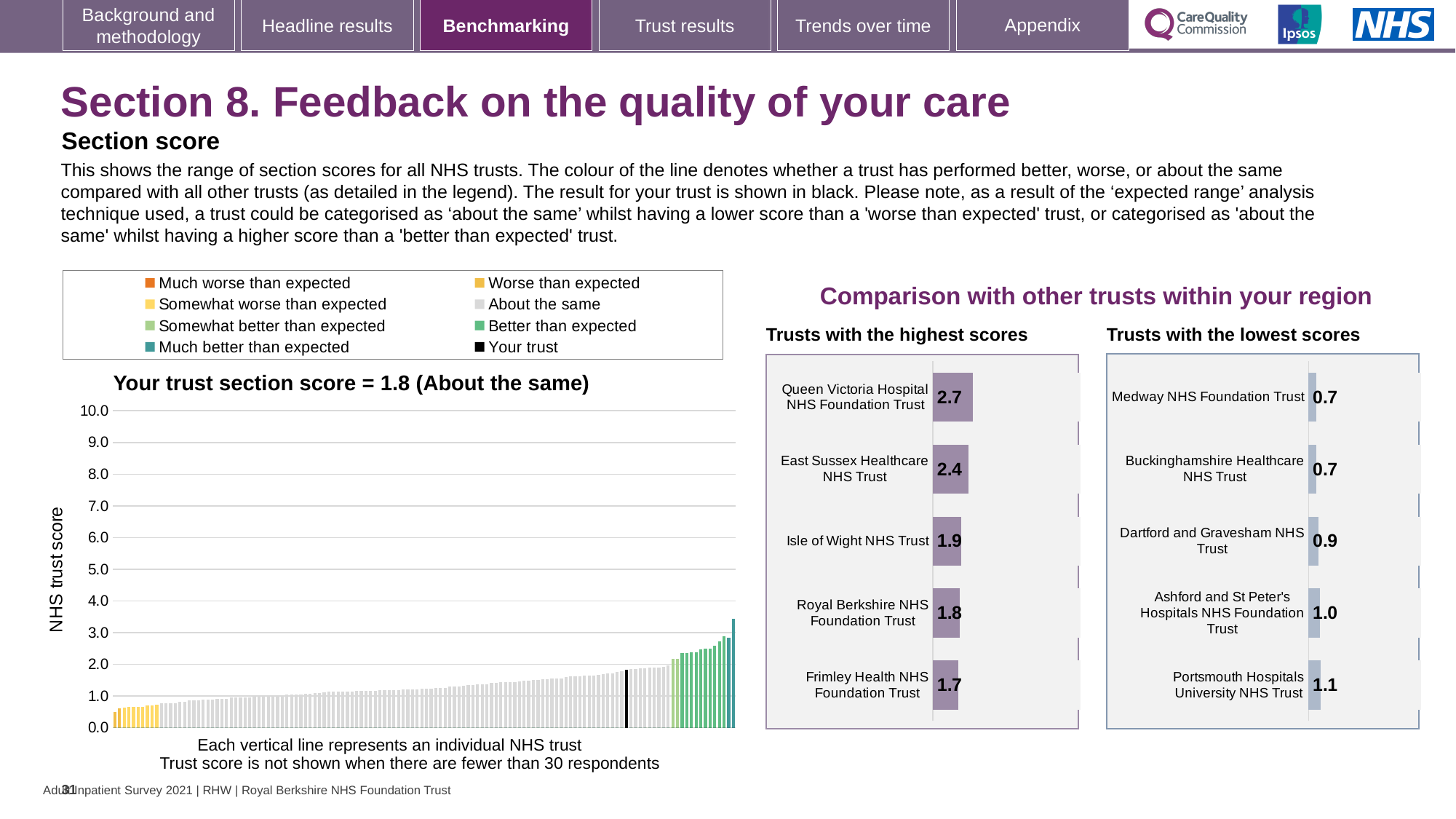
In the 'Trusts with the lowest scores' chart, which trust has the highest score? Portsmouth Hospitals University NHS Trust In the 'Your trust section score' chart, what is the section score for your trust? 1.8 In the 'Trusts with the lowest scores' chart, what is the difference between the scores of Portsmouth Hospitals University NHS Trust and Ashford and St Peter's Hospitals NHS Foundation Trust? 0.1 In the 'Trusts with the highest scores' chart, what is the score for Queen Victoria Hospital NHS Foundation Trust? 2.7 How many trusts are shown in the 'Trusts with the highest scores' chart? 5 What kind of chart is the 'Your trust section score' chart? bar chart In the 'Trusts with the highest scores' chart, what is the score for Isle of Wight NHS Trust? 1.9 In the 'Your trust section score' chart, do the trust scores rise or fall from left to right along the x axis? rise In the 'Trusts with the lowest scores' chart, is the score for Portsmouth Hospitals University NHS Trust larger or smaller than the score for Medway NHS Foundation Trust? larger In the 'Trusts with the highest scores' chart, which trust has the lowest score? Frimley Health NHS Foundation Trust In the 'Trusts with the highest scores' chart, what is the difference between the scores of Queen Victoria Hospital NHS Foundation Trust and Frimley Health NHS Foundation Trust? 1.0 In the 'Trusts with the lowest scores' chart, what is the score for Dartford and Gravesham NHS Trust? 0.9